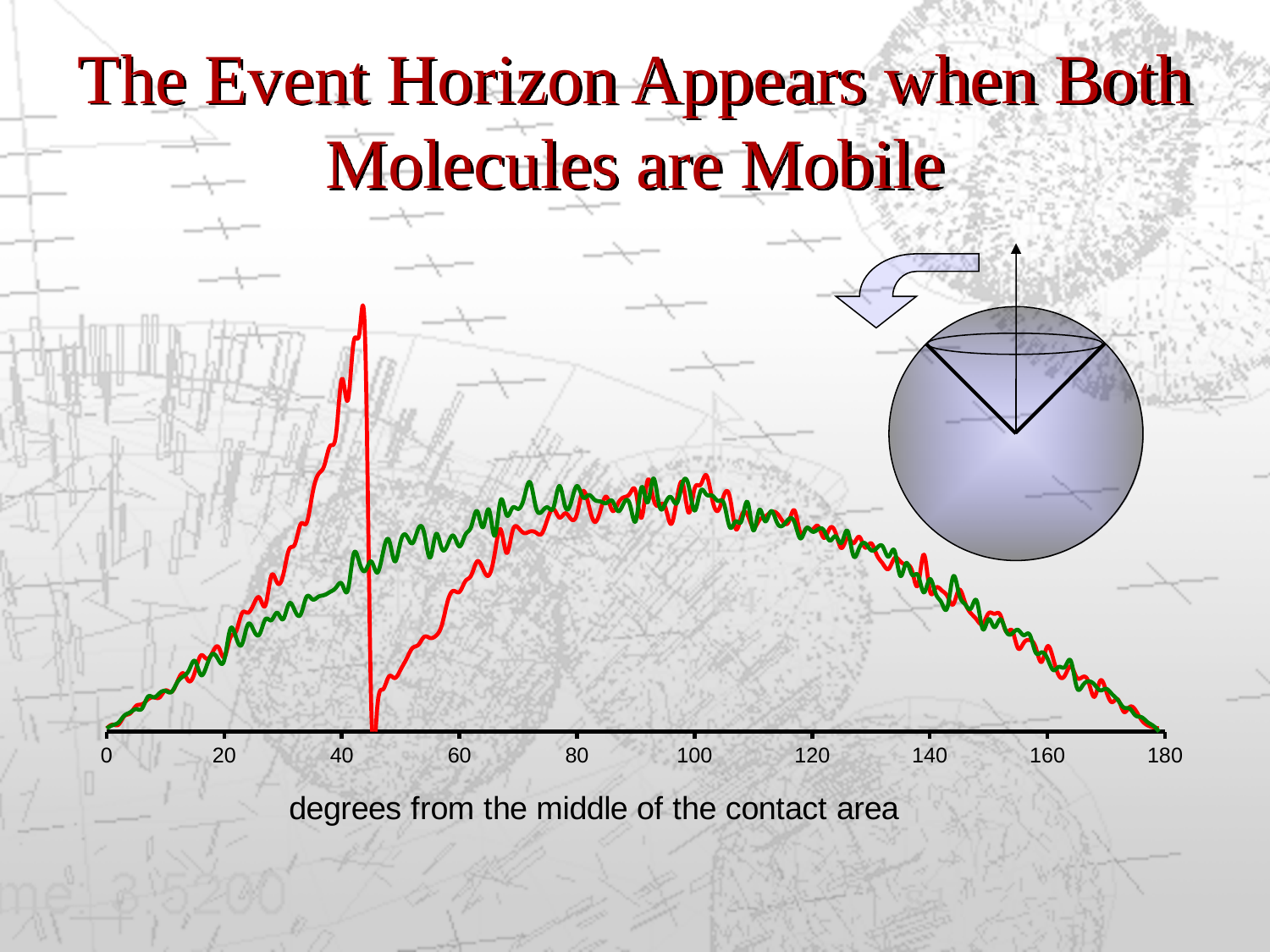
What is the label of the x axis? degrees from the middle of the contact area How many lines are plotted on the chart? 2 At 60 degrees, which line is higher, red or green? green What kind of chart is shown on the slide? line chart What is the spacing between consecutive labelled ticks on the x axis? 20 Which line reaches the higher peak, the red line or the green line? red Between which two labelled x-axis values does the red line drop sharply to the baseline? 40 and 60 At 40 degrees, which line is higher, red or green? red What is the highest value labelled on the x axis? 180 What colours are the two lines on the chart? red and green How many labelled tick values are shown on the x axis? 10 Does the green line rise or fall between 120 and 180 degrees? fall